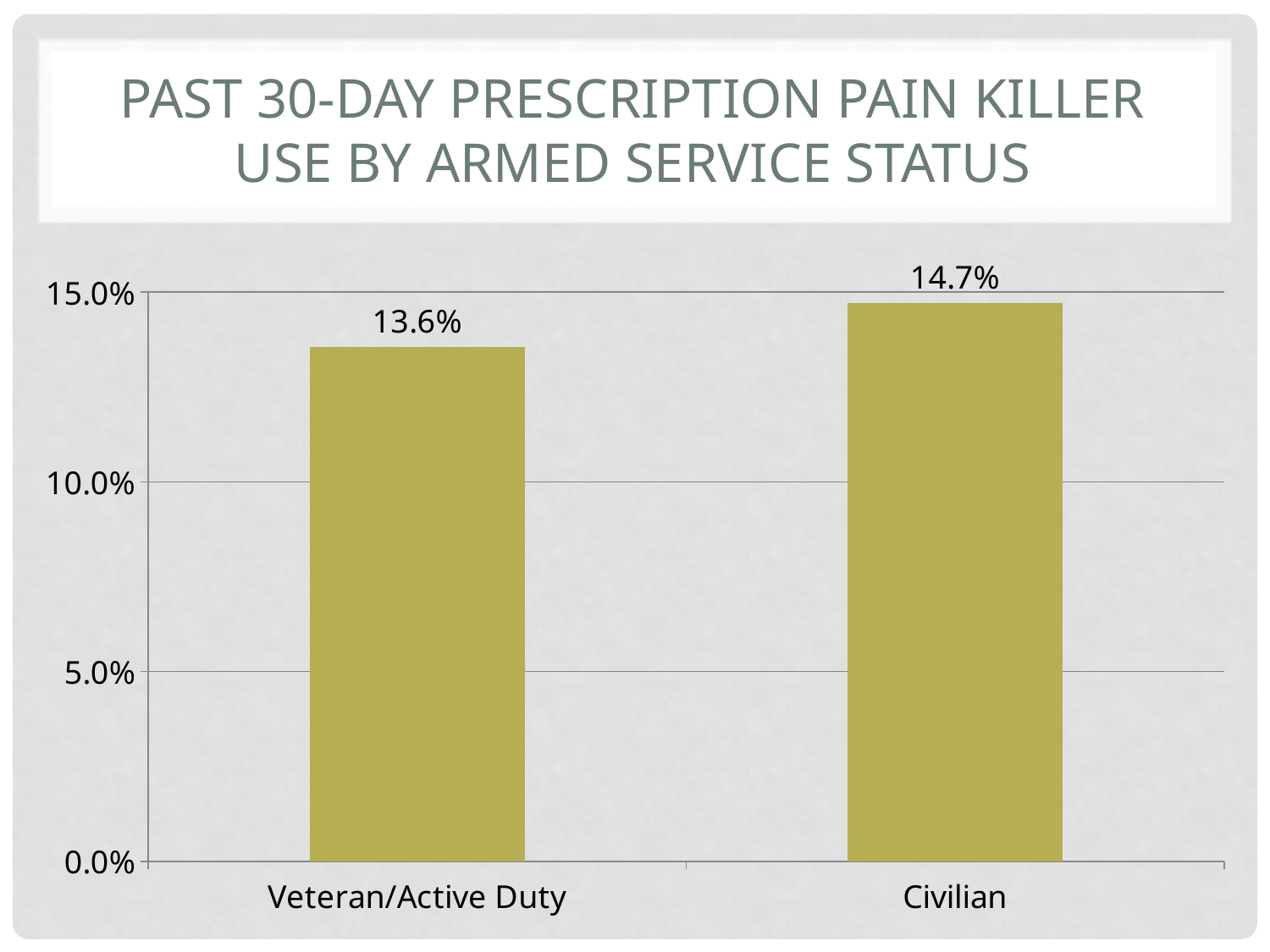
What is the title of the chart? Past 30-Day Prescription Pain Killer Use by Armed Service Status What is the past 30-day prescription pain killer use value for Veteran/Active Duty? 13.6% What kind of chart is shown on the slide? Bar chart What is the difference between the Civilian and Veteran/Active Duty values? 1.1% Is the value for Civilian greater or less than 15.0%? less What is the past 30-day prescription pain killer use value for Civilian? 14.7% What is the highest value shown on the y axis? 15.0% Which category has the highest value? Civilian How many categories are shown on the x axis? 2 Is the value for Veteran/Active Duty greater or less than 10.0%? greater Which category has the lowest value? Veteran/Active Duty Which is larger, the value for Civilian or the value for Veteran/Active Duty? Civilian